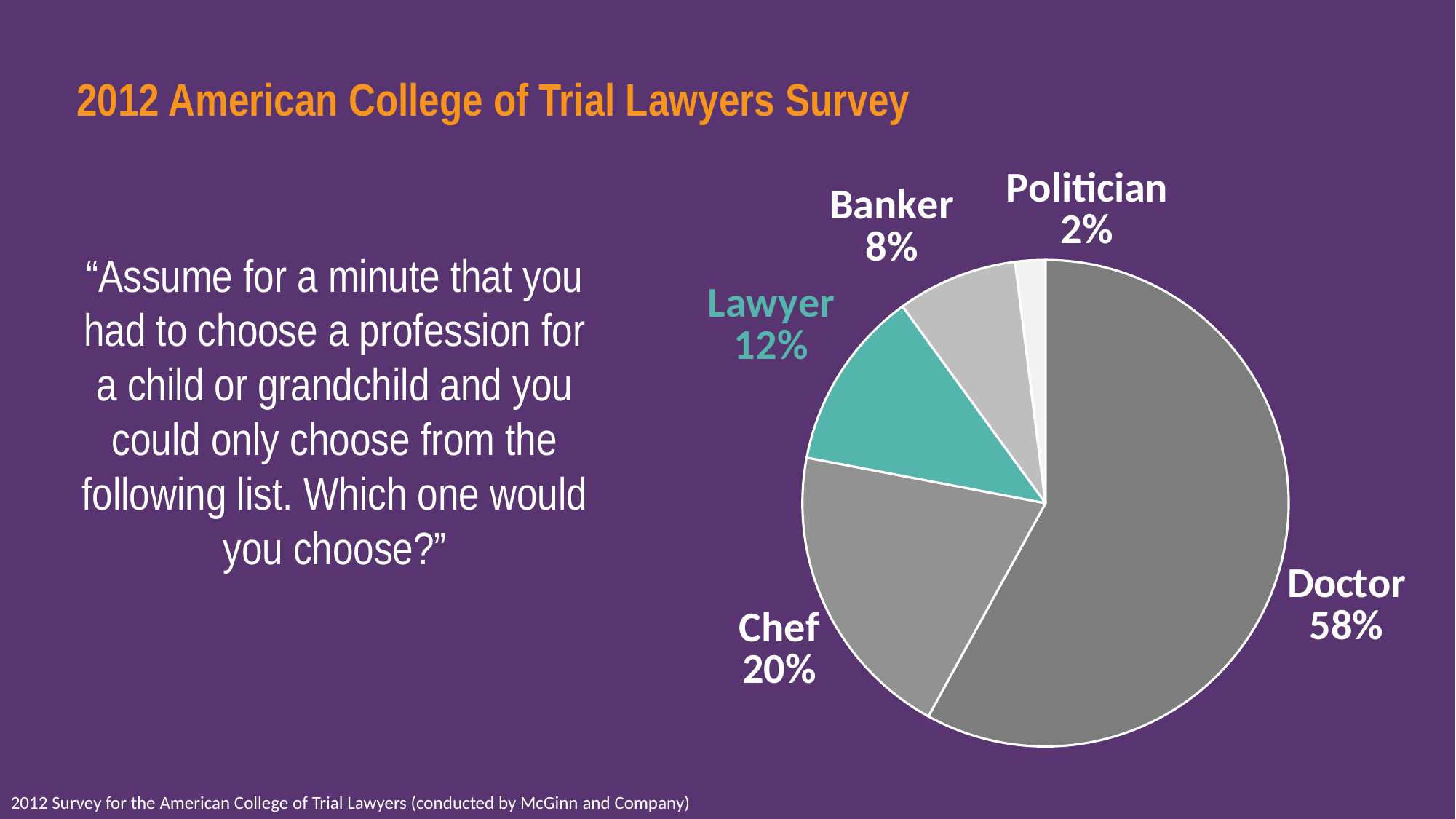
What percentage of respondents chose Doctor? 58% Which profession has the smallest share of the pie? Politician What is the difference in percentage points between Lawyer and Banker? 4 How many professions are shown in the pie chart? 5 Which slice of the pie is coloured teal rather than grey? Lawyer Which profession has the largest share of the pie? Doctor What kind of chart is shown on the slide? pie chart What is the difference in percentage points between Doctor and Chef? 38 Which has a larger share, Chef or Lawyer? Chef What percentage of respondents chose Politician? 2% What percentage of respondents chose Lawyer? 12% What percentage of respondents chose Chef? 20%